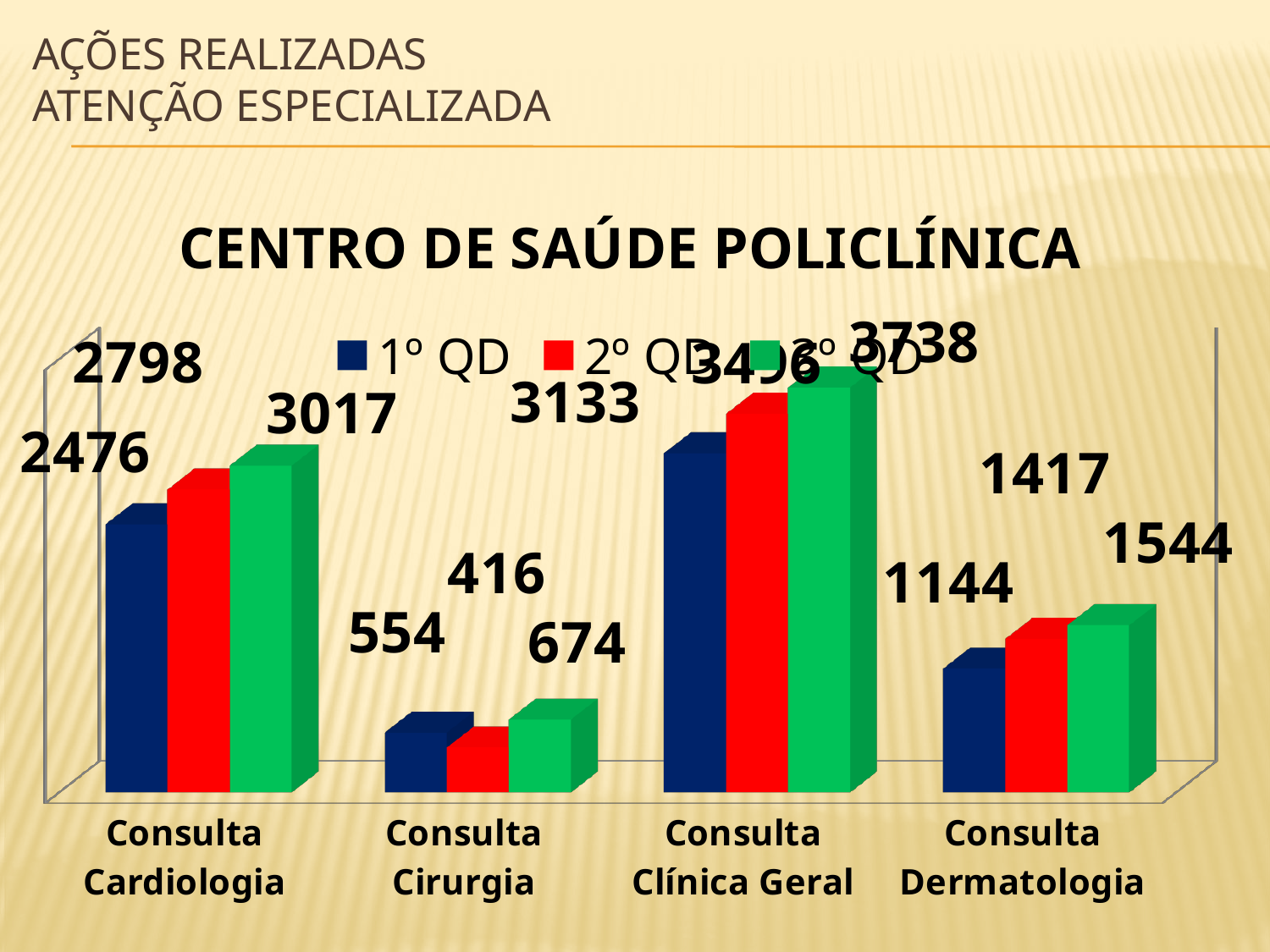
How many series does the legend list? 3 For Consulta Cirurgia, which is larger: the 1º QD value or the 2º QD value? 1º QD Which category has the lowest value in the 1º QD series? Consulta Cirurgia What kind of chart is shown on the slide? Bar chart How many categories are shown on the x axis? 4 Which category has the highest value in the 3º QD series? Consulta Clínica Geral What is the difference between the 3º QD and 1º QD values for Consulta Cardiologia? 541 What is the value for Consulta Cirurgia in the 2º QD series? 416 What is the value for Consulta Dermatologia in the 3º QD series? 1544 What is the value for Consulta Clínica Geral in the 1º QD series? 3133 What is the difference between the 3º QD and 1º QD values for Consulta Dermatologia? 400 What is the value for Consulta Cardiologia in the 1º QD series? 2476